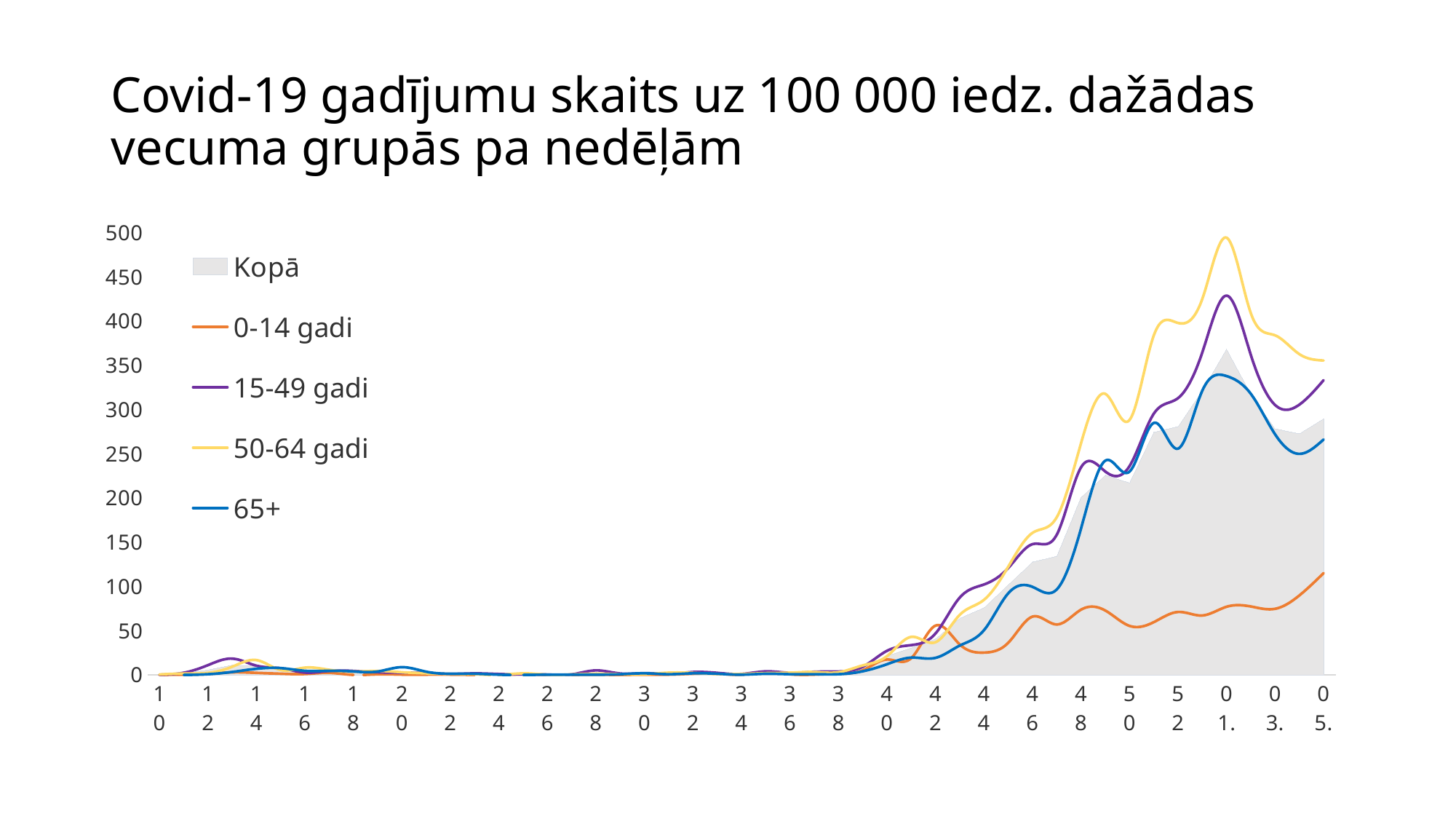
Which series is shown as a shaded grey area rather than a line? Kopā Is the value for 15-49 gadi at week 01. greater or less than 400? greater Which age group series has the lowest value at the last point (week 05.)? 0-14 gadi What is the title of the chart? Covid-19 gadījumu skaits uz 100 000 iedz. dažādas vecuma grupās pa nedēļām What kind of chart is shown on the slide? combination area and line chart Is the value for 65+ at week 01. greater or less than 300? greater Do the values for 15-49 gadi rise or fall between week 38 and week 01.? rise Which age group series reaches the highest value on the chart? 50-64 gadi Is the value for 0-14 gadi at week 05. greater or less than 100? greater At week 01., which is larger: the value for 50-64 gadi or the value for 65+? 50-64 gadi How many series does the legend list? 5